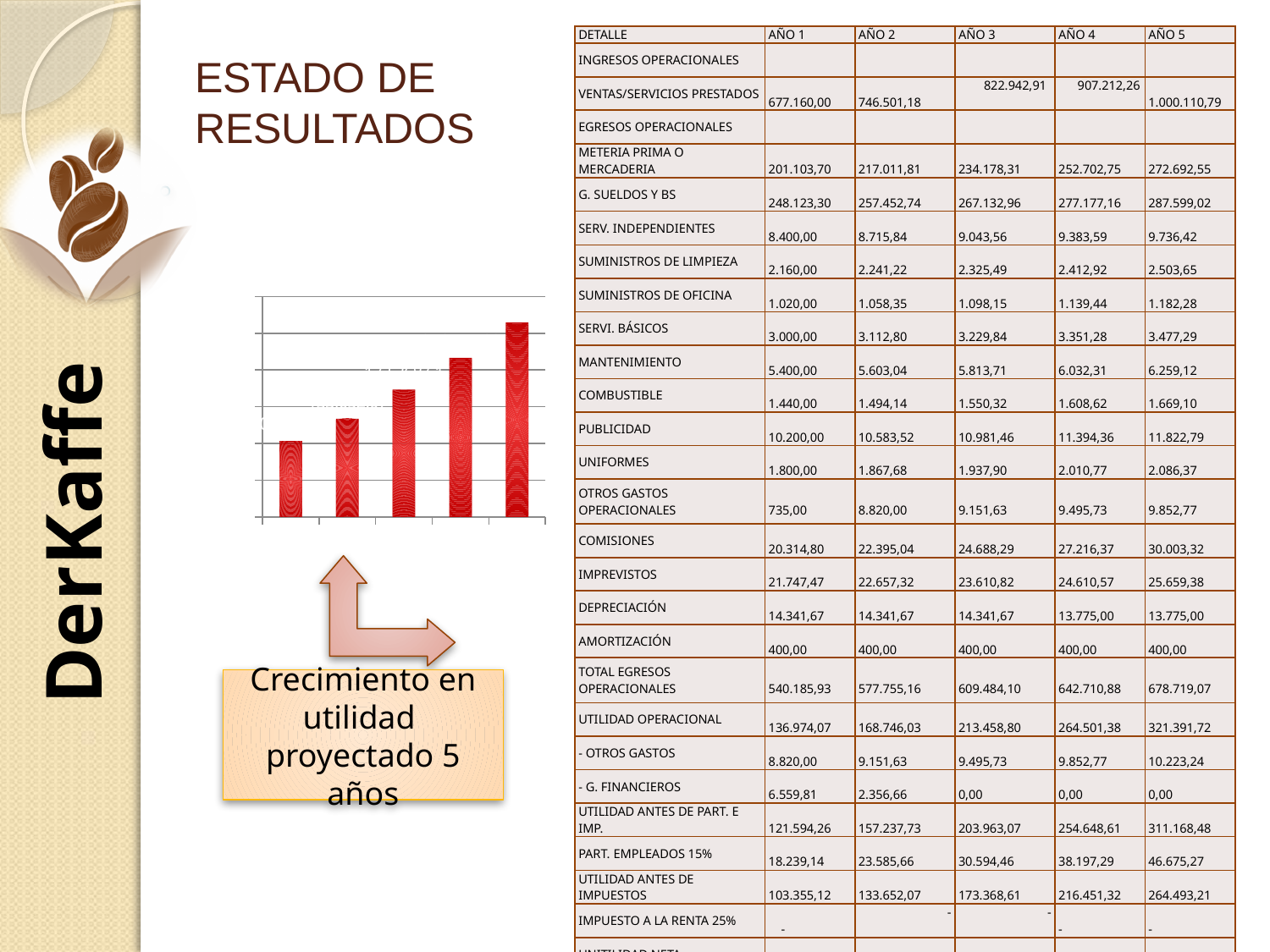
Do the bar values rise or fall from left to right across the chart? rise Is the fourth bar in the chart taller or shorter than the fifth bar? shorter Are the bars in the chart vertical or horizontal? vertical What kind of chart is shown on the slide? bar chart Which bar in the chart is the shortest? the first (leftmost) bar Is the first bar in the chart taller or shorter than the fourth bar? shorter How many bars does the chart on the slide contain? 5 Is the third bar in the chart taller or shorter than the second bar? taller Which bar in the chart is the tallest? the fifth (rightmost) bar What colour are the bars in the chart? red